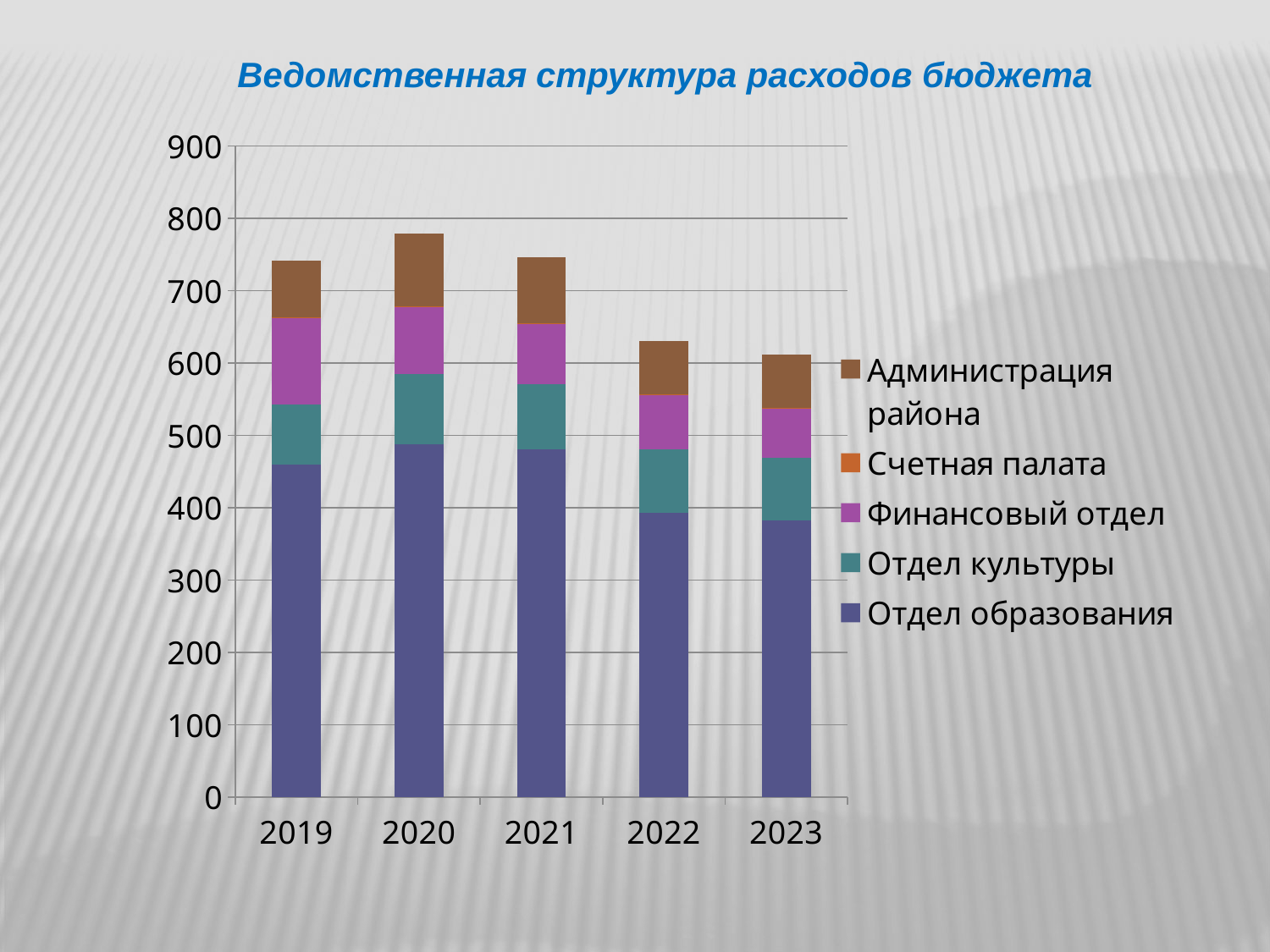
Is the value for Отдел образования in 2019 greater or less than 400? greater What kind of chart is shown on the slide? Stacked bar chart Do the total bar heights rise or fall from 2021 to 2023? fall Which series forms the bottom segment of each stacked bar? Отдел образования Is the total bar for 2019 greater or less than 700? greater Is the total bar for 2022 greater or less than 700? less Which total bar is larger, 2020 or 2022? 2020 What is the title of the chart? Ведомственная структура расходов бюджета Which year has the highest total bar? 2020 How many years are shown on the x axis of the chart? 5 How many series does the legend list? 5